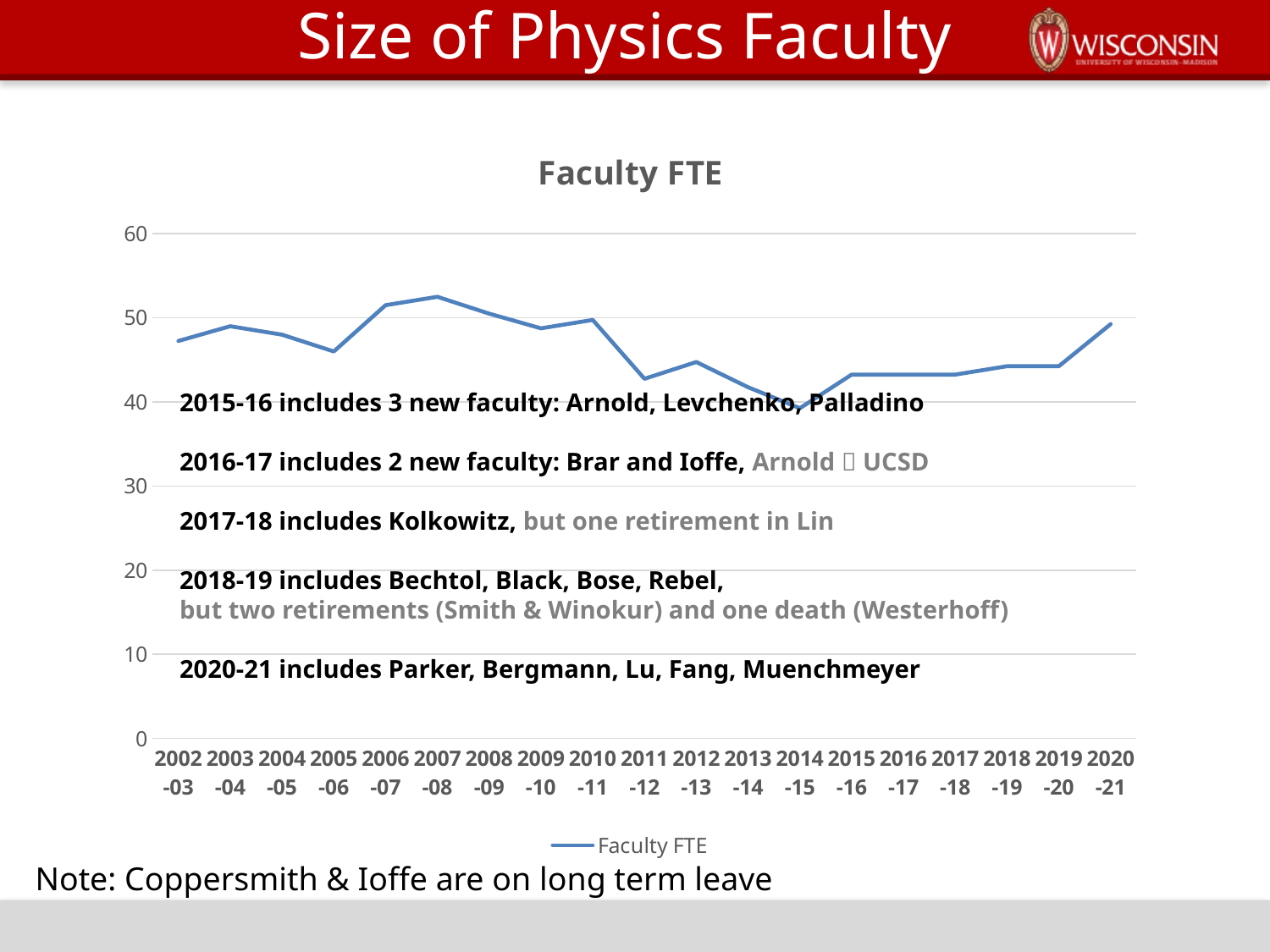
What kind of chart is shown on the slide? line chart Is the Faculty FTE value for 2011-12 greater or less than 50? less Which year has the larger Faculty FTE value, 2019-20 or 2020-21? 2020-21 Which year has the larger Faculty FTE value, 2007-08 or 2014-15? 2007-08 Does the Faculty FTE value rise or fall from 2017-18 to 2020-21? rise What is the title of the chart? Faculty FTE How many academic years are plotted along the x axis? 19 Is the Faculty FTE value for 2007-08 greater or less than 50? greater Is the Faculty FTE value for 2014-15 greater or less than 50? less Does the Faculty FTE value rise or fall from 2007-08 to 2014-15? fall How many series does the legend list? 1